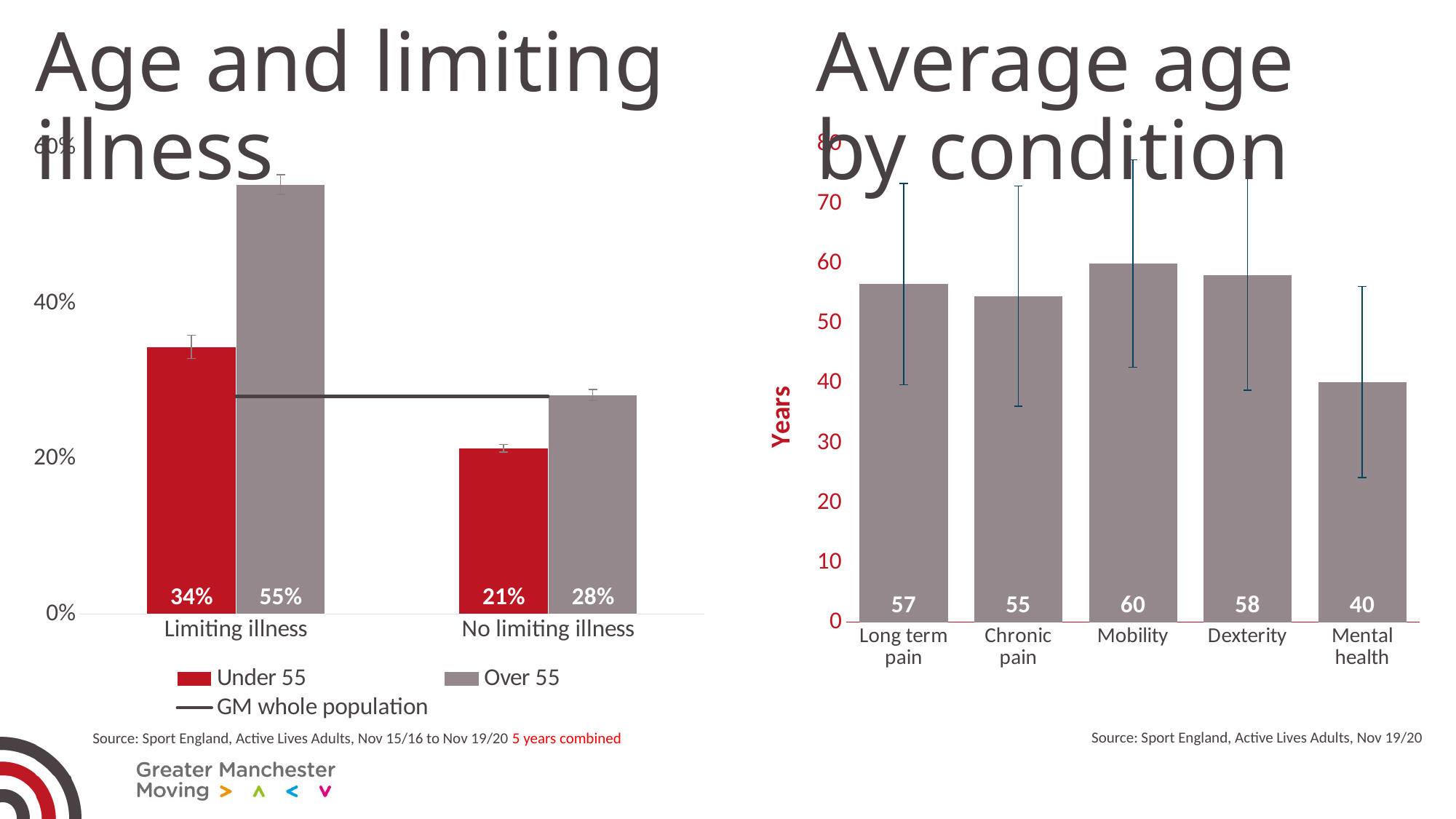
In the 'Average age by condition' chart, what is the average age for Dexterity? 58 In the 'Average age by condition' chart, what is the difference between the average age for Mobility and Mental health? 20 In the 'Average age by condition' chart, how many conditions are shown? 5 In the 'Age and limiting illness' chart, which is larger for No limiting illness: Under 55 or Over 55? Over 55 In the 'Age and limiting illness' chart, what is the value for Under 55 in the No limiting illness category? 21% In the 'Average age by condition' chart, which condition has the highest average age? Mobility In the 'Age and limiting illness' chart, what is the value for Over 55 in the Limiting illness category? 55% In the 'Age and limiting illness' chart, what is the difference between the Over 55 and Under 55 values for Limiting illness? 21% What kind of chart is the 'Average age by condition' chart? Bar chart In the 'Average age by condition' chart, which condition has the lowest average age? Mental health In the 'Age and limiting illness' chart, how many entries does the legend list? 3 In the 'Age and limiting illness' chart, what colour are the Under 55 bars? Red